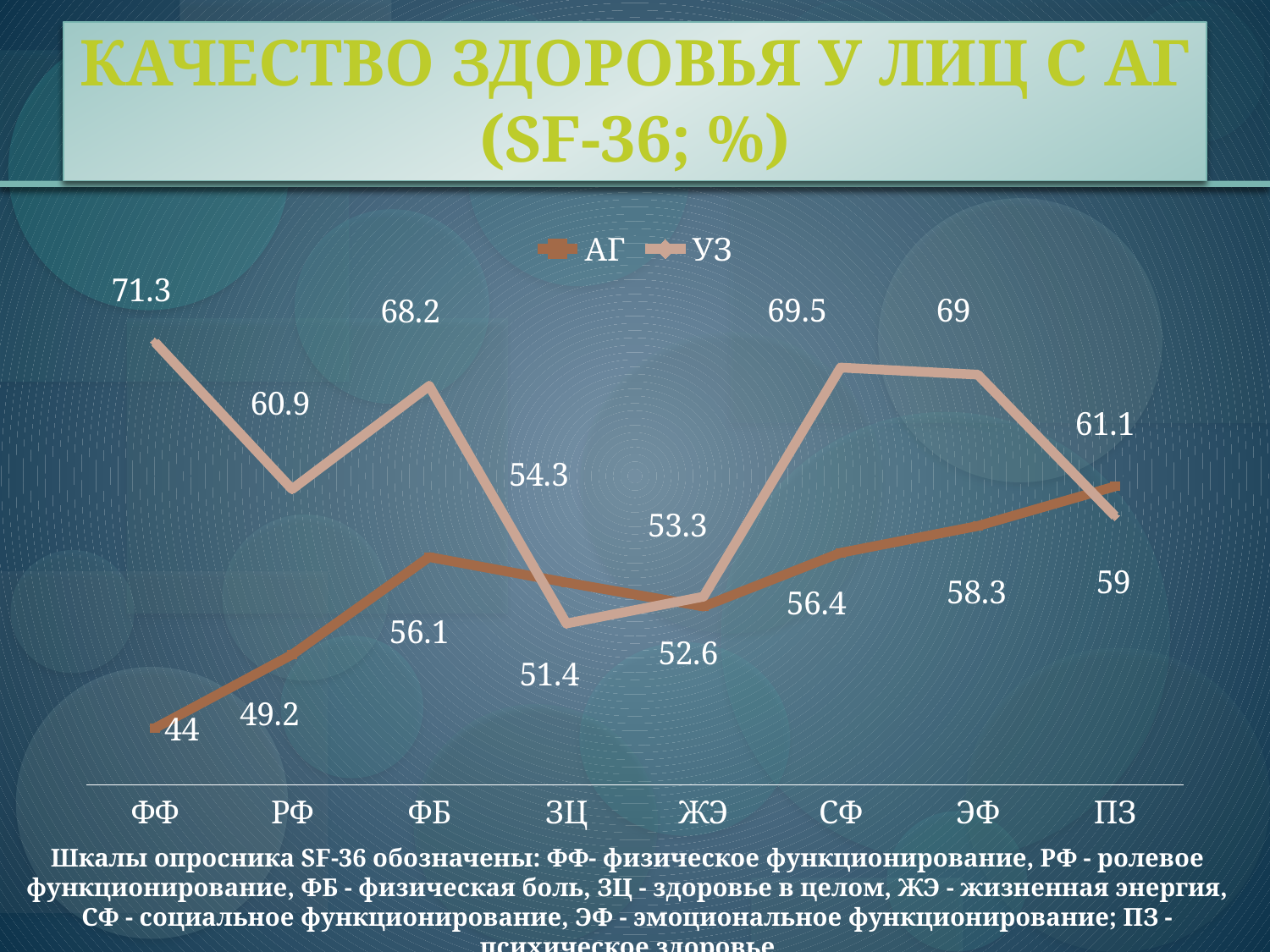
Which category has the lowest value in the АГ series? ФФ What is the value of the АГ series for ЭФ? 58.3 What is the value of the АГ series for ФФ? 44 What are the two series named in the legend? АГ and УЗ What is the difference between the УЗ and АГ values for ФФ? 27.3 Which category has the highest value in the УЗ series? ФФ What type of chart is shown on the slide? line chart What is the value of the УЗ series for ФФ? 71.3 For ПЗ, which series has the larger value, АГ or УЗ? АГ How many categories are shown on the x axis? 8 How many series does the legend list? 2 What is the value of the УЗ series for СФ? 69.5